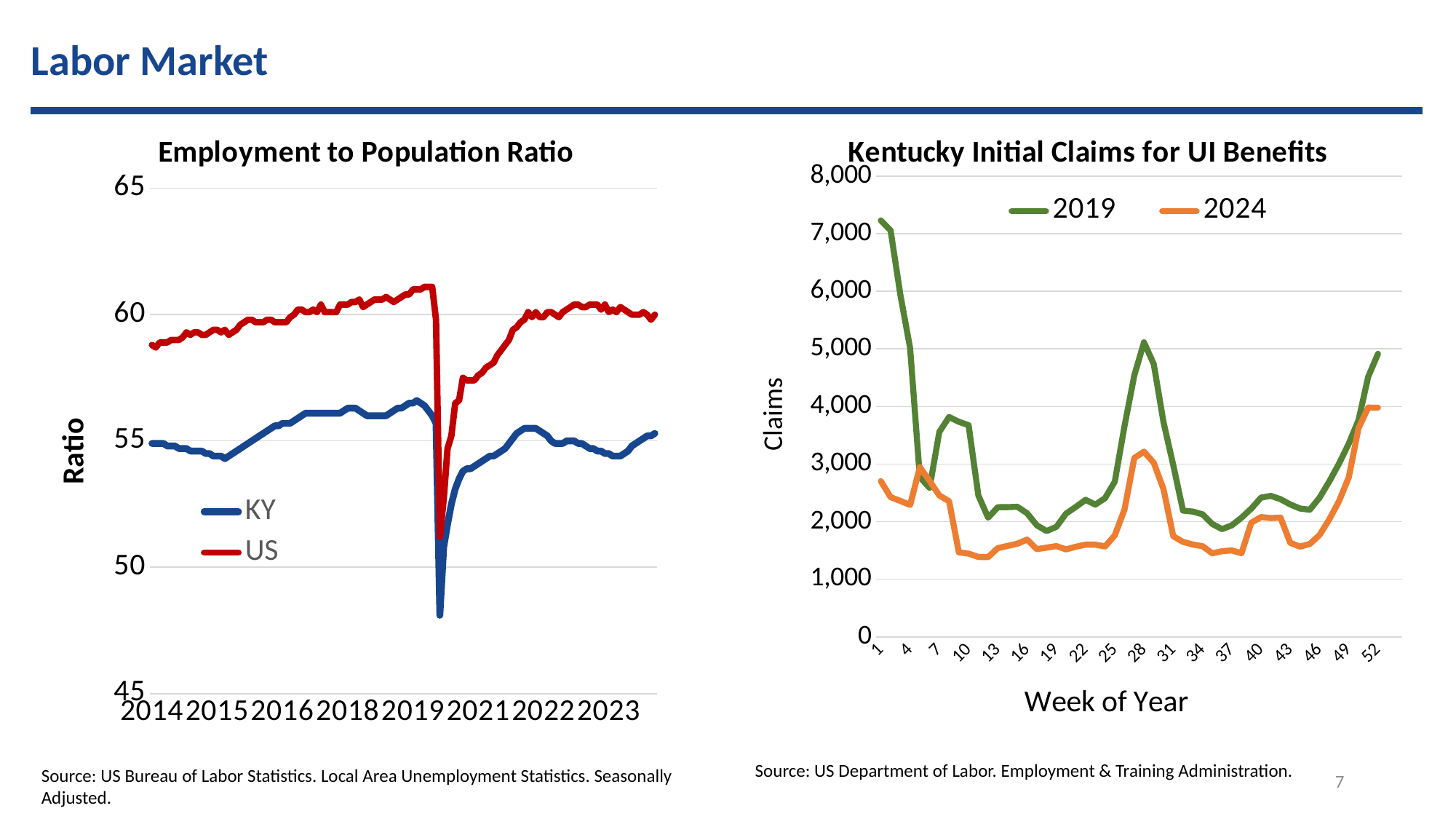
What kind of chart is the 'Kentucky Initial Claims for UI Benefits' chart? line chart In the 'Kentucky Initial Claims for UI Benefits' chart, what colour is the 2024 series line? orange In the 'Kentucky Initial Claims for UI Benefits' chart, which series is higher at week 1, 2019 or 2024? 2019 How many series does the legend of the 'Employment to Population Ratio' chart list? 2 In the 'Employment to Population Ratio' chart, which series is higher throughout the period, KY or US? US In the 'Employment to Population Ratio' chart, is the lowest value of the KY series greater or less than 50? less In the 'Employment to Population Ratio' chart, is the US series at the end of 2023 greater or less than 55? greater In the 'Kentucky Initial Claims for UI Benefits' chart, do the 2019 claims rise or fall between week 1 and week 13? fall In the 'Kentucky Initial Claims for UI Benefits' chart, is the 2019 value at week 1 greater or less than 6,000? greater What kind of chart is the 'Employment to Population Ratio' chart? line chart How many series does the legend of the 'Kentucky Initial Claims for UI Benefits' chart list? 2